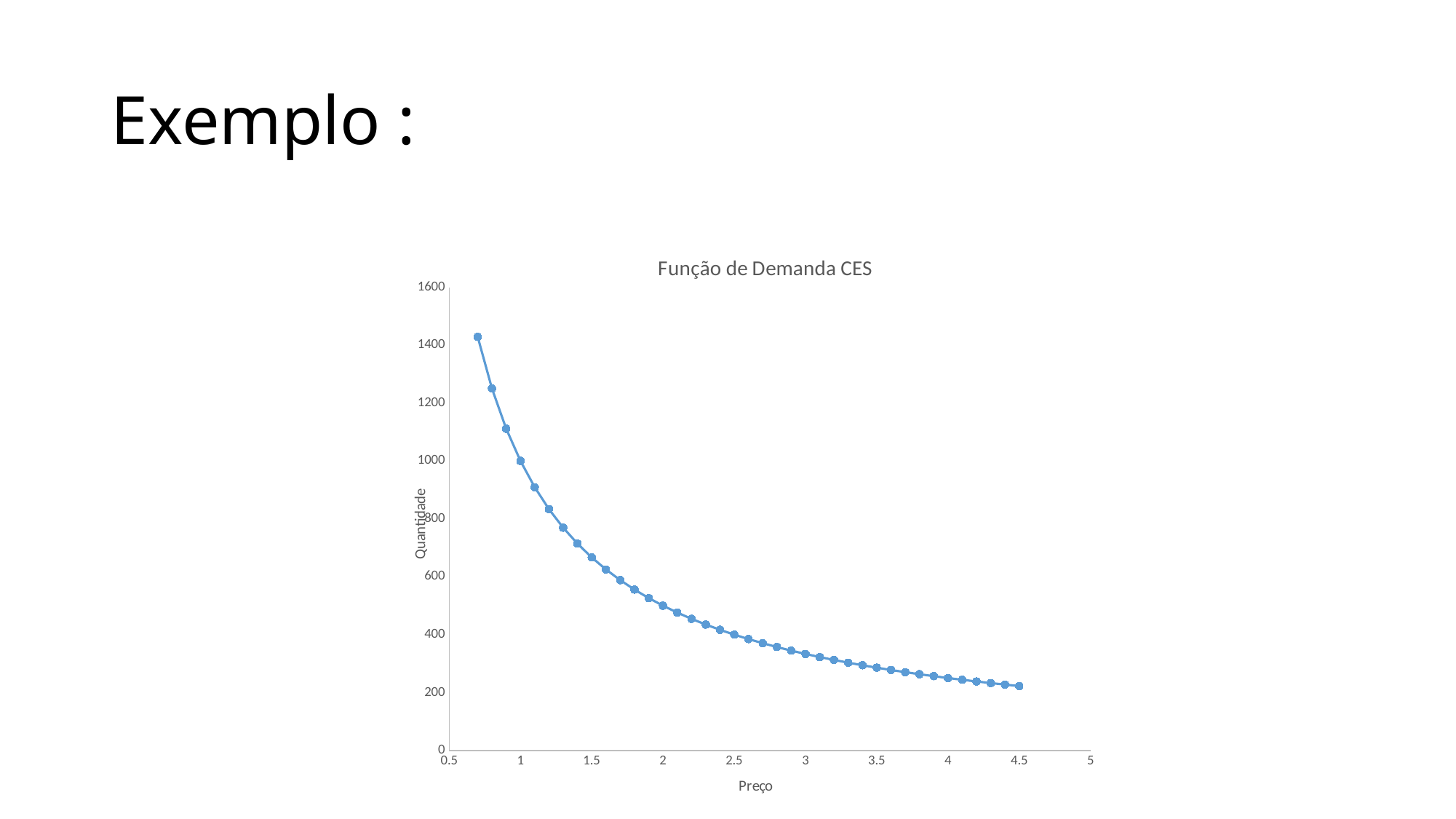
Which has the larger Quantidade, Preço 1 or Preço 2? Preço 1 What is the label of the x axis? Preço At which Preço value is Quantidade highest? 0.7 Is the Quantidade at Preço 1.5 greater or less than 600? greater What is the title of the chart? Função de Demanda CES Is the Quantidade at Preço 3 greater or less than 400? less Is the Quantidade at Preço 1.2 greater or less than 800? greater At which Preço value is Quantidade lowest? 4.5 Do the values of Quantidade rise or fall as Preço increases? fall What kind of chart is shown on the slide? line chart